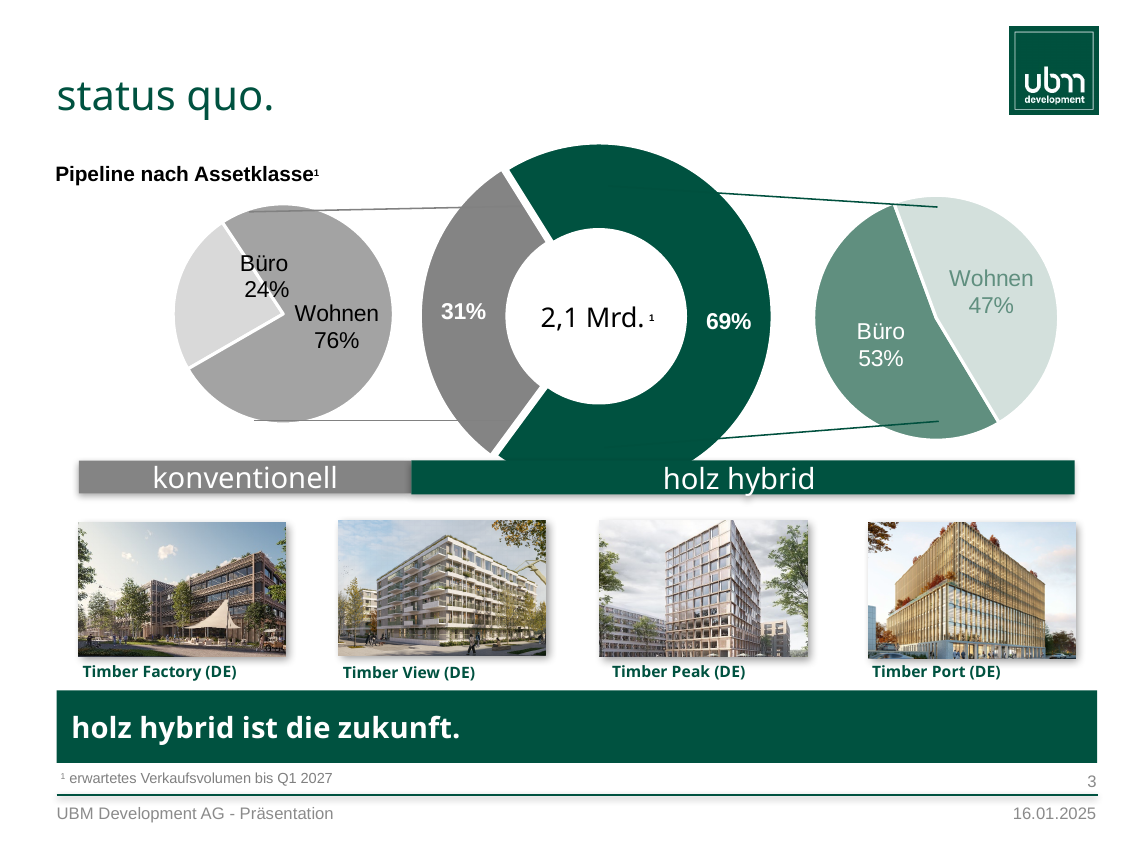
In the left pie chart (konventionell), what share does Wohnen have? 76% In the right pie chart (holz hybrid), what share does Wohnen have? 47% What value is printed in the centre of the central donut chart? 2,1 Mrd. In the right pie chart (holz hybrid), which category is the largest? Büro In the left pie chart (konventionell), which category is larger, Büro or Wohnen? Wohnen In the central donut chart, what is the difference in percentage points between the holz hybrid and konventionell segments? 38 percentage points In the central donut chart, what share is labelled for the konventionell segment? 31% What is the title given above the charts on the slide? Pipeline nach Assetklasse In the right pie chart (holz hybrid), what share does Büro have? 53% How many segments does the central donut chart have? 2 In the central donut chart, what share is labelled for the holz hybrid segment? 69%